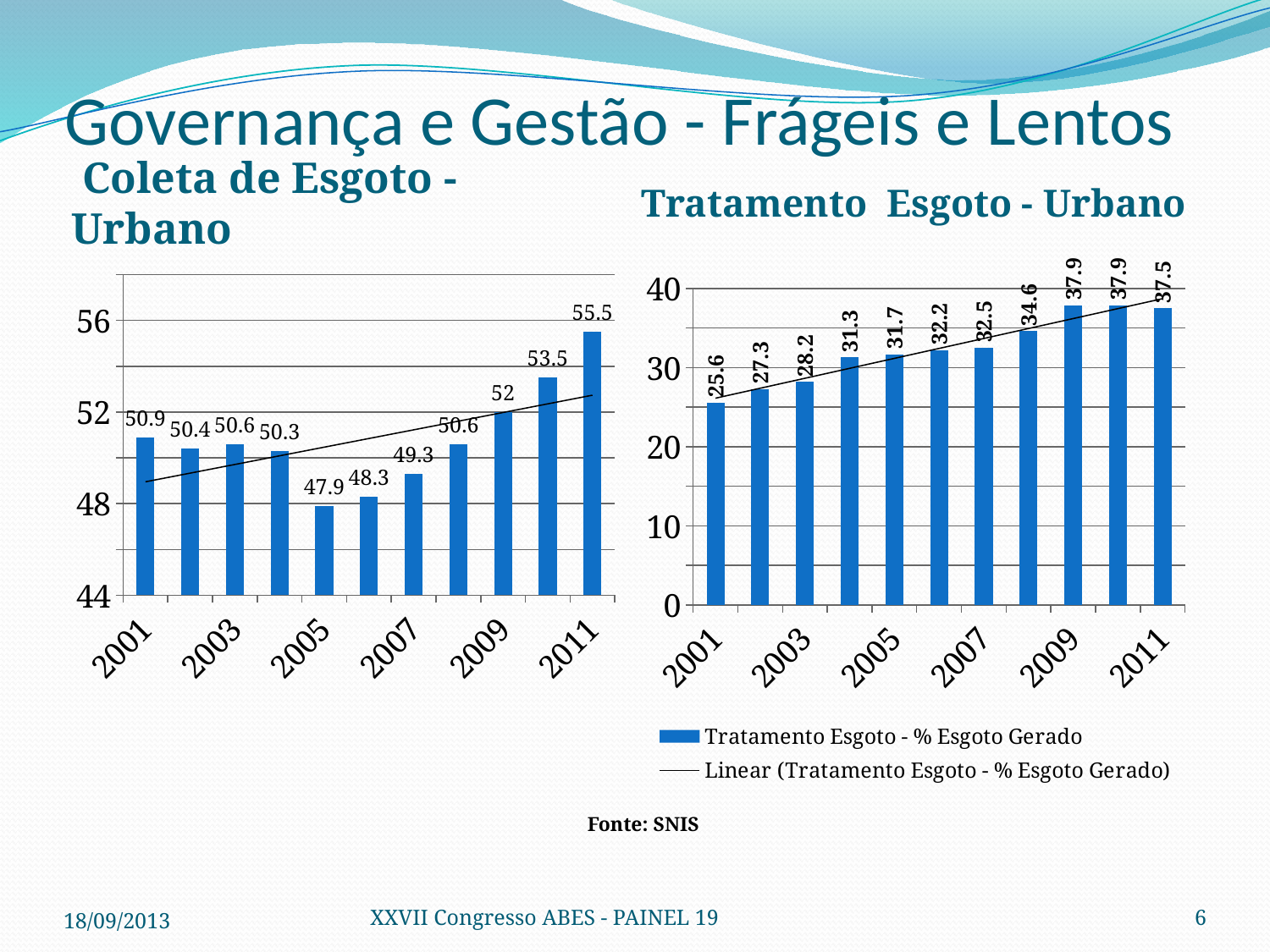
In the 'Coleta de Esgoto - Urbano' chart, what is the value for 2005? 47.9 In the 'Coleta de Esgoto - Urbano' chart, what is the value for 2011? 55.5 How many entries does the legend of the 'Tratamento Esgoto - Urbano' chart list? 2 In the 'Tratamento Esgoto - Urbano' chart, which year has the lowest value? 2001 In the 'Coleta de Esgoto - Urbano' chart, what is the difference between the values for 2011 and 2009? 3.5 In the 'Tratamento Esgoto - Urbano' chart, is the value for 2007 larger or smaller than the value for 2003? larger How many bars are plotted in the 'Tratamento Esgoto - Urbano' chart? 11 In the 'Tratamento Esgoto - Urbano' chart, what is the difference between the values for 2011 and 2001? 11.9 In the 'Coleta de Esgoto - Urbano' chart, which year has the lowest value? 2005 In the 'Tratamento Esgoto - Urbano' chart, what is the value for 2009? 37.9 In the 'Tratamento Esgoto - Urbano' chart, what is the value for 2001? 25.6 In the 'Coleta de Esgoto - Urbano' chart, which year has the highest value? 2011